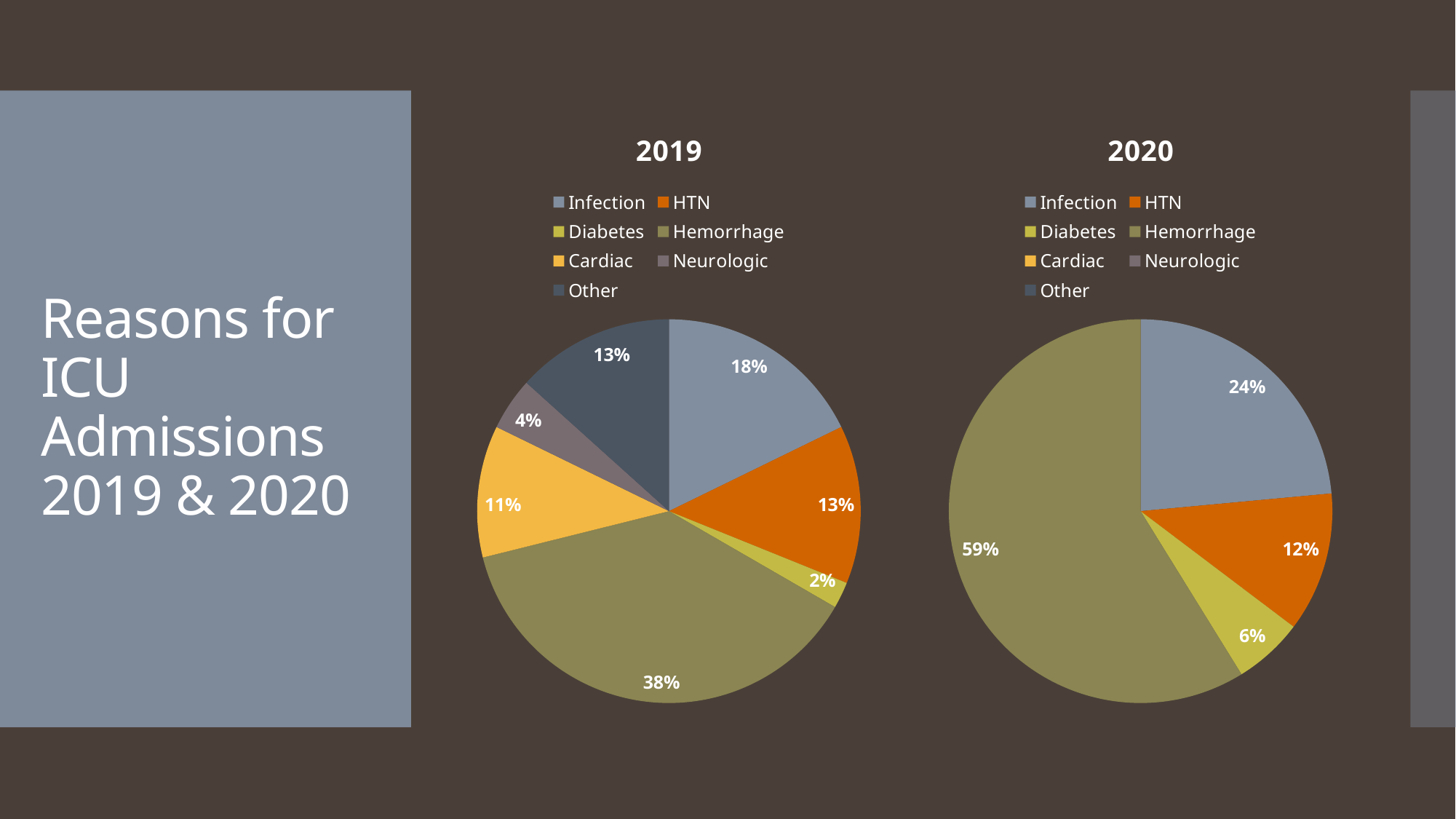
In the 2020 pie chart, what percentage is shown for Diabetes? 6% In the 2019 pie chart, what percentage is shown for Hemorrhage? 38% What type of chart is used for the 2019 data? Pie chart In the 2020 pie chart, what percentage is shown for Infection? 24% In the 2019 pie chart, which category has the largest slice? Hemorrhage In the 2019 pie chart, which is larger: Cardiac or HTN? HTN How many slices does the 2019 pie chart have? 7 In the 2020 pie chart, what share of the pie does HTN represent? 12% In the 2019 pie chart, which category has the smallest slice? Diabetes How many categories does the legend of the 2020 chart list? 7 In the 2020 pie chart, what is the difference in percentage points between Hemorrhage and Infection? 35% In the 2019 pie chart, what is the difference in percentage points between Infection and Other? 5%